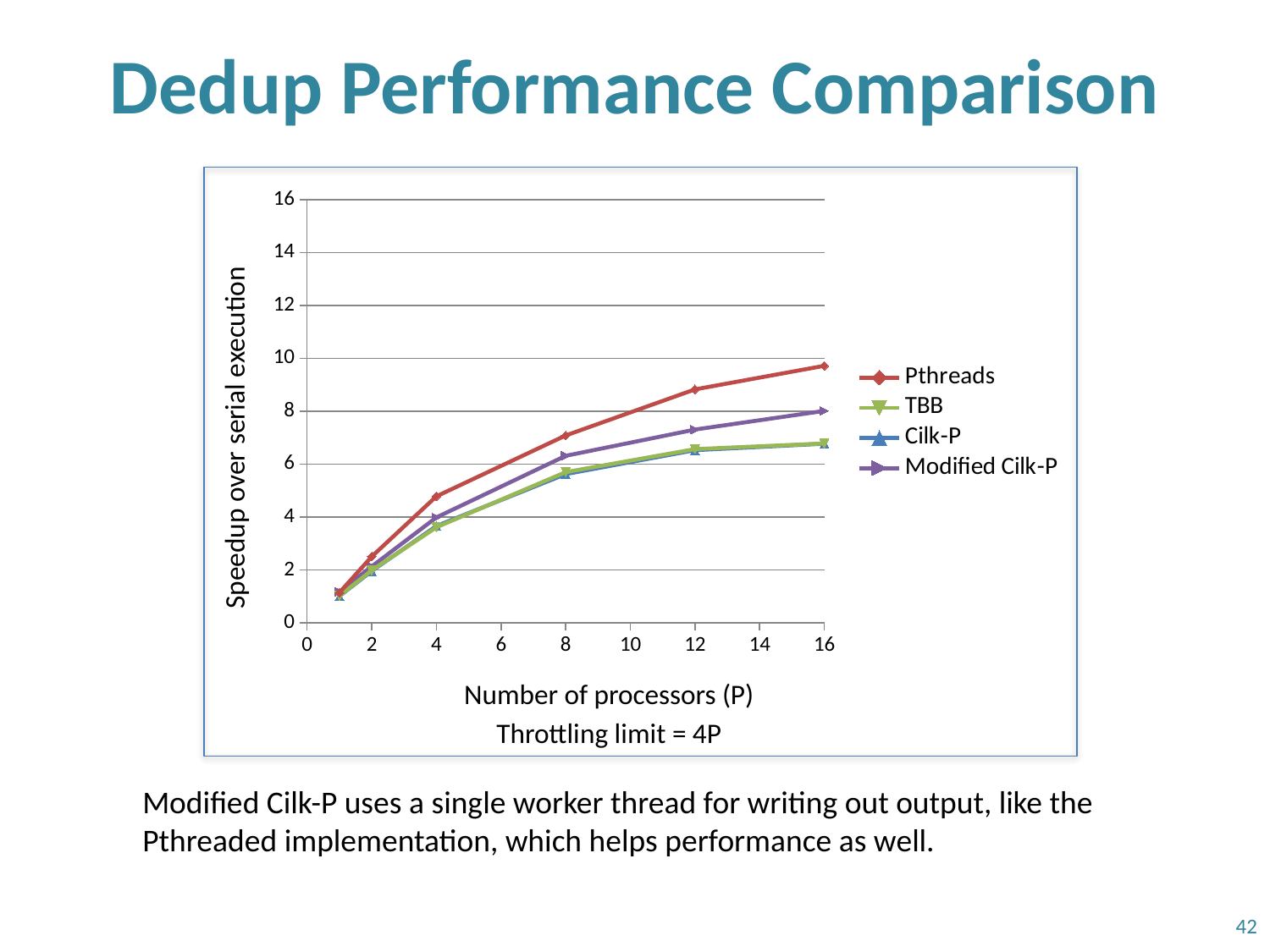
How many series does the legend list? 4 Is the speedup for Cilk-P at 8 processors greater or less than 6? less What is the label of the y axis? Speedup over serial execution Is the speedup for TBB at 16 processors greater or less than 8? less How many data points are plotted for the Pthreads series? 6 Which series has the highest speedup at 16 processors? Pthreads Is the speedup for Pthreads at 16 processors greater or less than 8? greater Which is larger at 12 processors, the speedup for Modified Cilk-P or for TBB? Modified Cilk-P Does the speedup for Pthreads rise or fall as the number of processors increases? Rises What kind of chart is shown on the slide? Line chart